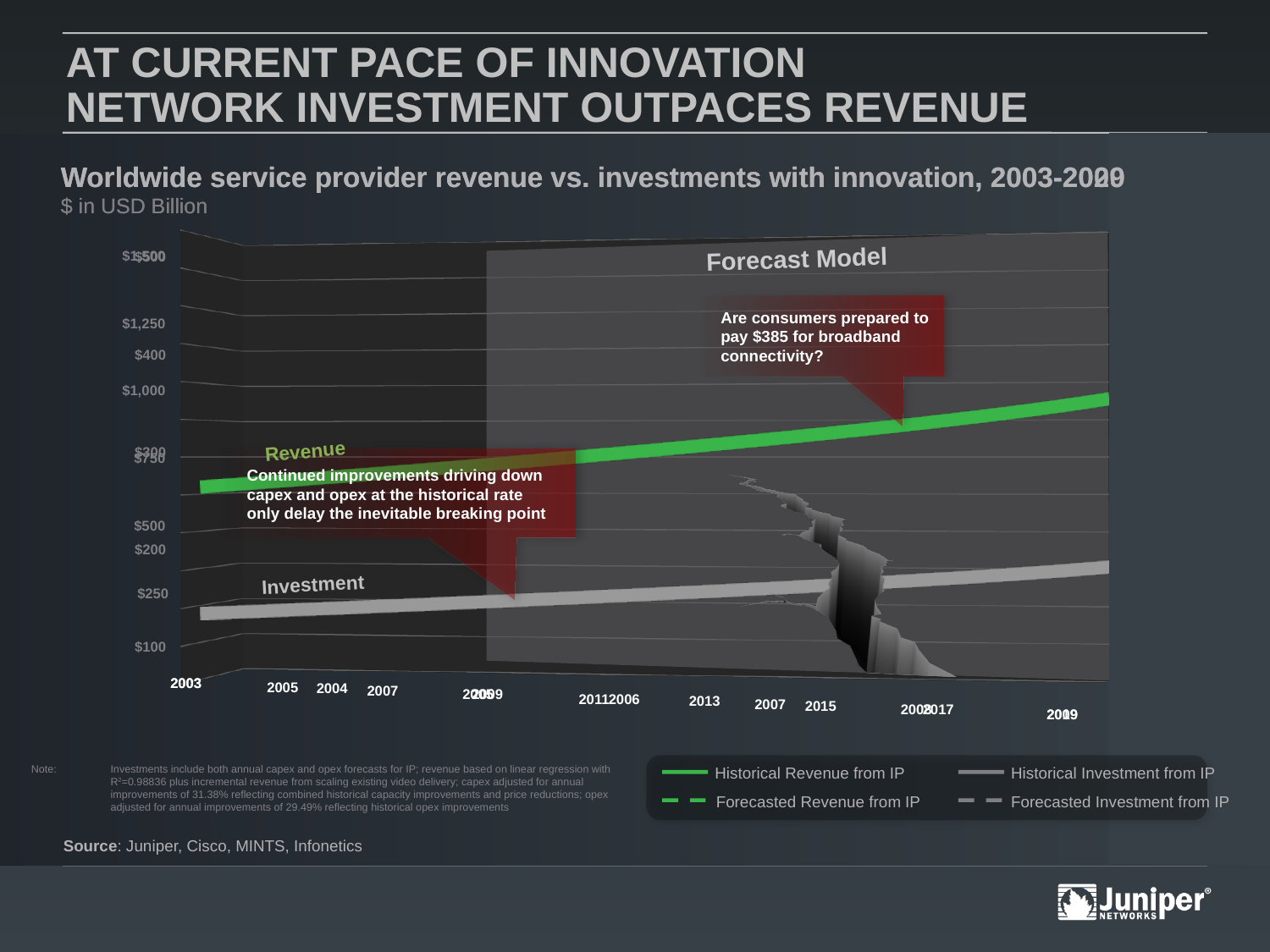
Which of the two plotted lines is the highest across the chart? Revenue What unit is stated for the chart's values? $ in USD Billion Which line is higher at 2003, Revenue or Investment? Revenue Which of the two plotted lines is the lowest across the chart? Investment Does the Investment line rise or fall from 2003 to 2019? rise Does the Revenue line rise or fall from 2003 to 2019? rise Which line is higher at 2019, Revenue or Investment? Revenue What colour is the Revenue line? green What kind of chart is shown on the slide? line chart How many lines are plotted on the chart? 2 How many series does the legend list? 4